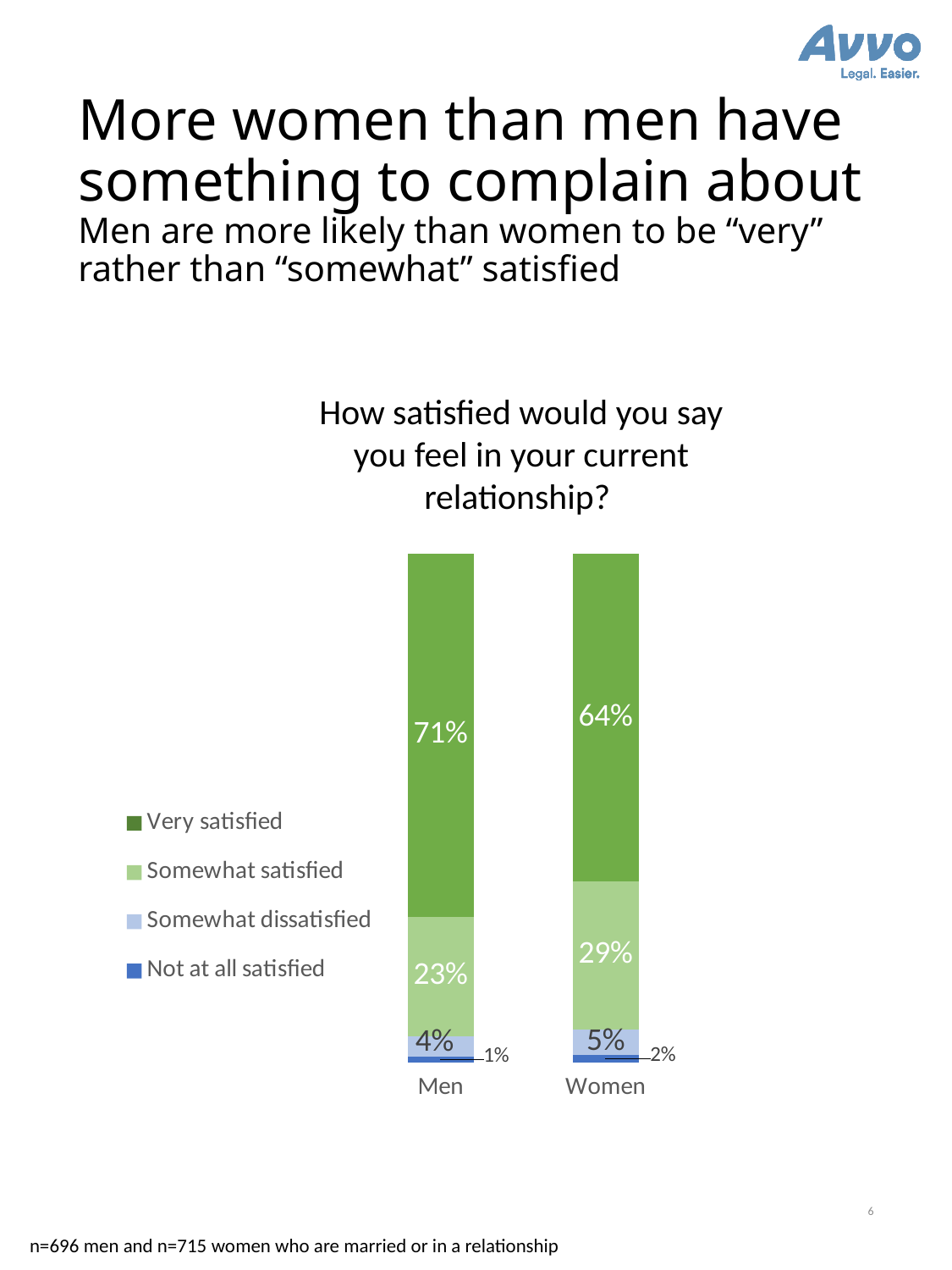
What is the difference between the 'Somewhat satisfied' percentages for women and men? 6% Which group has the higher share of 'Very satisfied' respondents, men or women? Men Which group has the higher share of 'Somewhat satisfied' respondents, men or women? Women What kind of chart is shown on the slide? Stacked bar chart What percentage of women are very satisfied in their current relationship? 64% What percentage of women are somewhat satisfied? 29% How many series does the legend list? 4 What percentage of men are somewhat dissatisfied? 4% What percentage of men are very satisfied in their current relationship? 71% What is the difference between the 'Very satisfied' percentages for men and women? 7% How many categories are shown on the x axis? 2 What percentage of women are not at all satisfied? 2%